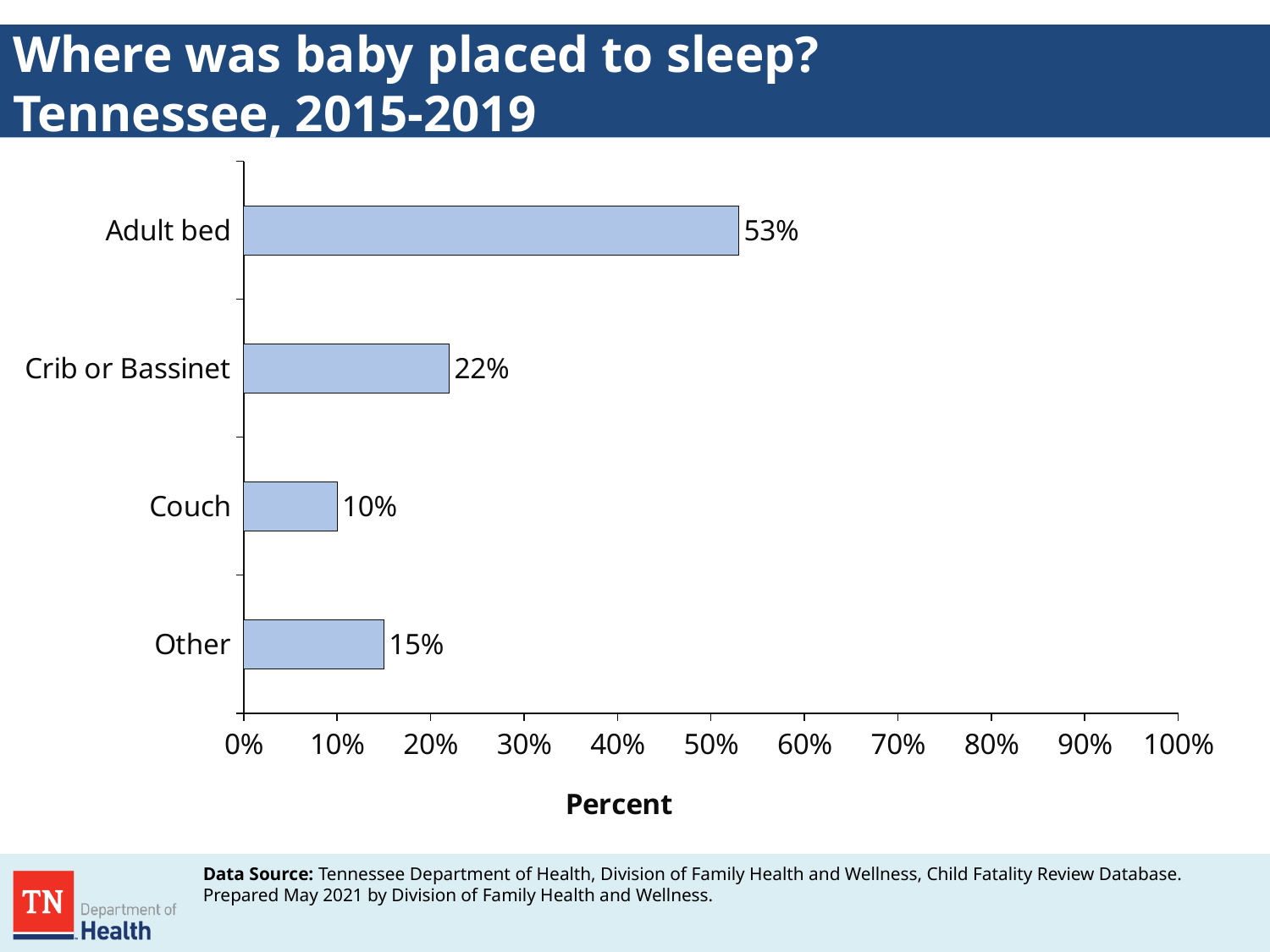
What percentage of babies were placed to sleep in an adult bed? 53% Which sleep location has the lowest percentage? Couch Is the value for Adult bed greater or less than 50%? greater What kind of chart is shown on the slide? Bar chart What is the label on the horizontal axis of the chart? Percent What is the value for Couch? 10% What is the value for Crib or Bassinet? 22% Which sleep location has the highest percentage? Adult bed What is the difference between the Adult bed and Crib or Bassinet percentages? 31% What is the value for Other? 15% How many sleep location categories are shown in the chart? 4 Which is larger, the value for Other or the value for Couch? Other